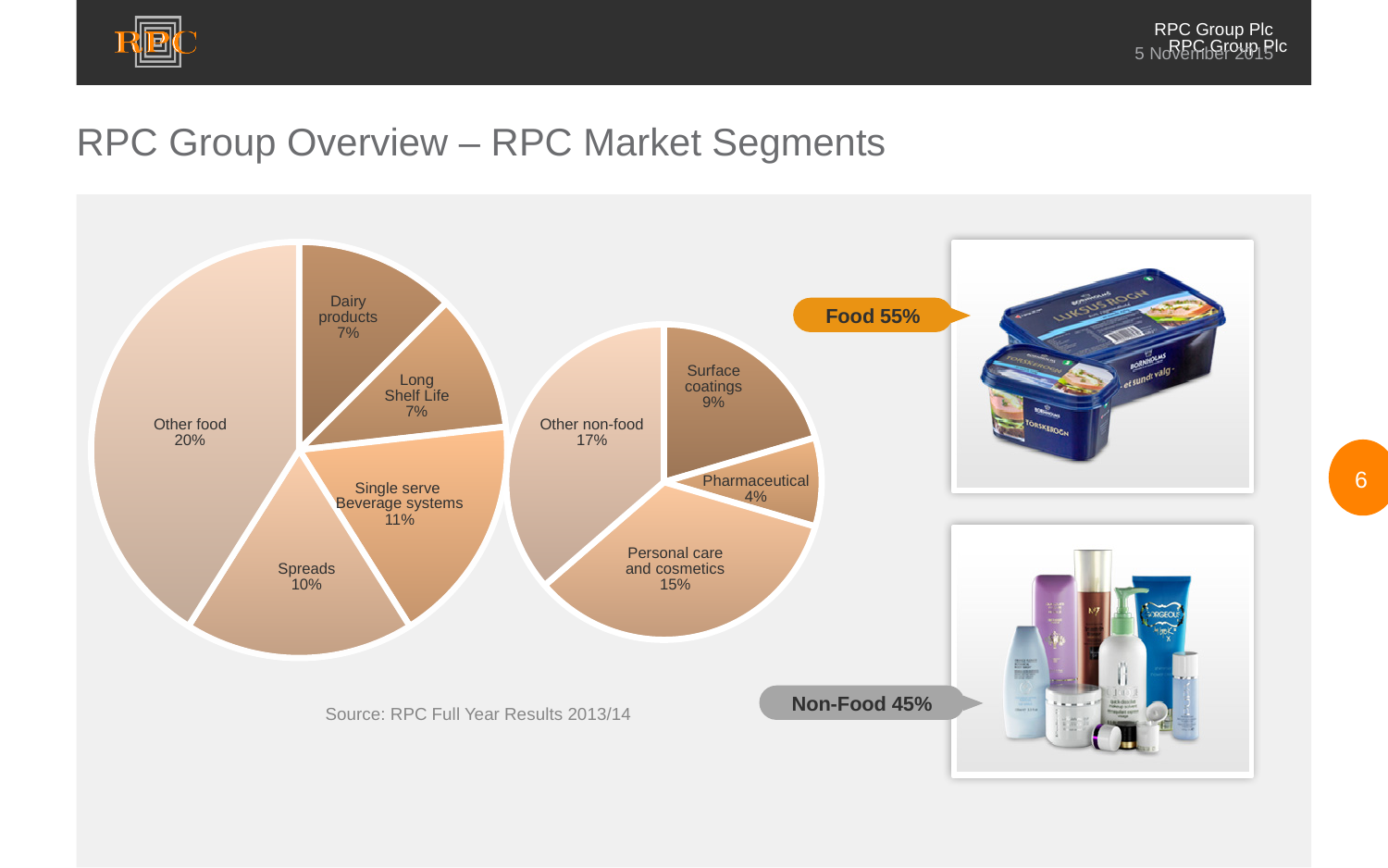
In the right pie chart (Non-Food), what percentage is shown for Pharmaceutical? 4% In the left pie chart (Food), what percentage is shown for Spreads? 10% What type of chart is used to show the market segments on this slide? Pie chart In the left pie chart (Food), which segment has the largest share? Other food What total share is labelled for the Food pie chart? 55% How many segments does the left pie chart (Food) have? 5 In the right pie chart (Non-Food), which is larger: Surface coatings or Personal care and cosmetics? Personal care and cosmetics In the right pie chart (Non-Food), what is the difference between Other non-food and Surface coatings? 8% What source is cited for the charts on the slide? RPC Full Year Results 2013/14 In the right pie chart (Non-Food), which segment has the smallest share? Pharmaceutical How many segments does the right pie chart (Non-Food) have? 4 In the left pie chart (Food), what is the difference between Other food and Single serve Beverage systems? 9%